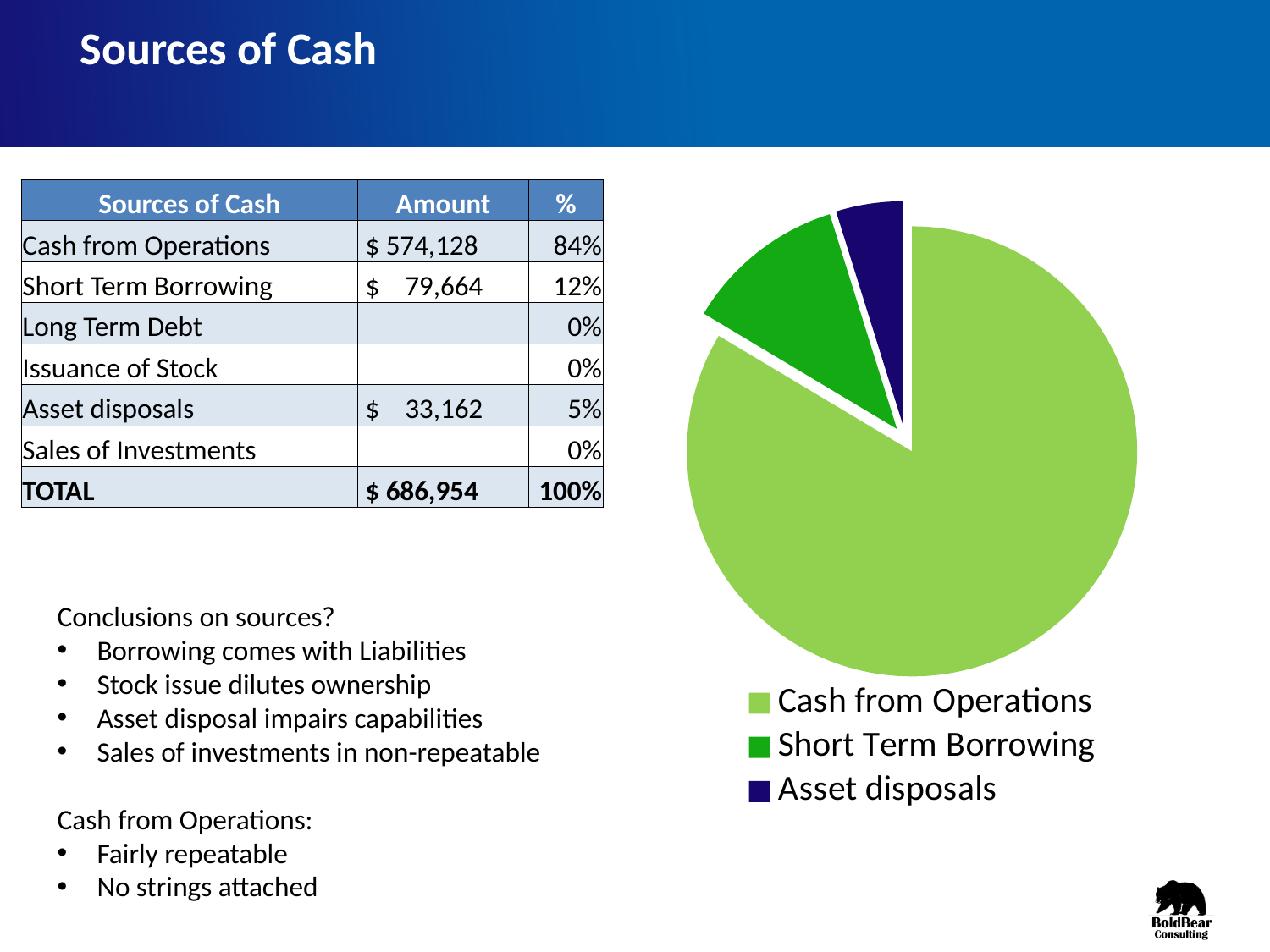
What share of the pie does Short Term Borrowing represent? 12% Which slice is larger in the pie chart, Short Term Borrowing or Asset disposals? Short Term Borrowing What kind of chart is shown on the slide? pie chart How many slices does the pie chart have? 3 What is the amount for Cash from Operations shown on the slide? $ 574,128 How many entries does the pie chart's legend list? 3 What colour is the Asset disposals slice in the pie chart? dark blue What is the amount for Asset disposals shown on the slide? $ 33,162 Which source of cash has the largest slice in the pie chart? Cash from Operations Which source of cash has the smallest slice in the pie chart? Asset disposals What share of the pie does Cash from Operations represent? 84% What share of the pie does Asset disposals represent? 5%